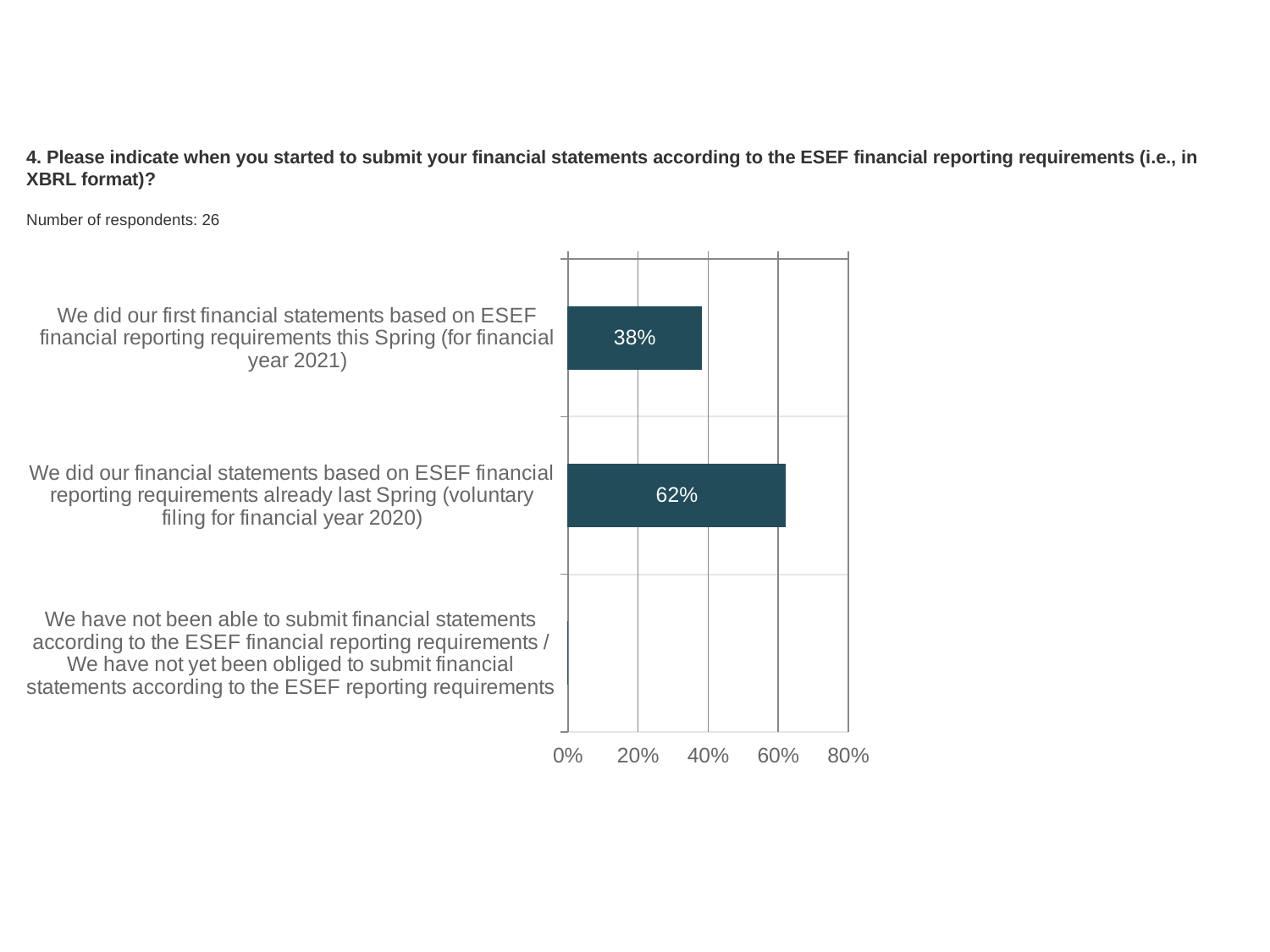
Which is larger: the share for 'this Spring (for financial year 2021)' or the share for 'already last Spring (voluntary filing for financial year 2020)'? already last Spring (voluntary filing for financial year 2020) What kind of chart is shown on the slide? Bar chart Which response option has the highest percentage? We did our financial statements based on ESEF financial reporting requirements already last Spring (voluntary filing for financial year 2020) What is the highest value shown on the x axis? 80% What is the difference in percentage points between the 'already last Spring' option and the 'this Spring' option? 24 percentage points Is the value for 'already last Spring (voluntary filing for financial year 2020)' greater or less than 60%? greater How many respondents answered this question? 26 What percentage of respondents did their ESEF-based financial statements already last Spring (voluntary filing for financial year 2020)? 62% How many response categories are shown on the chart? 3 Is the value for 'this Spring (for financial year 2021)' greater or less than 40%? less What percentage of respondents did their first ESEF-based financial statements this Spring (for financial year 2021)? 38%